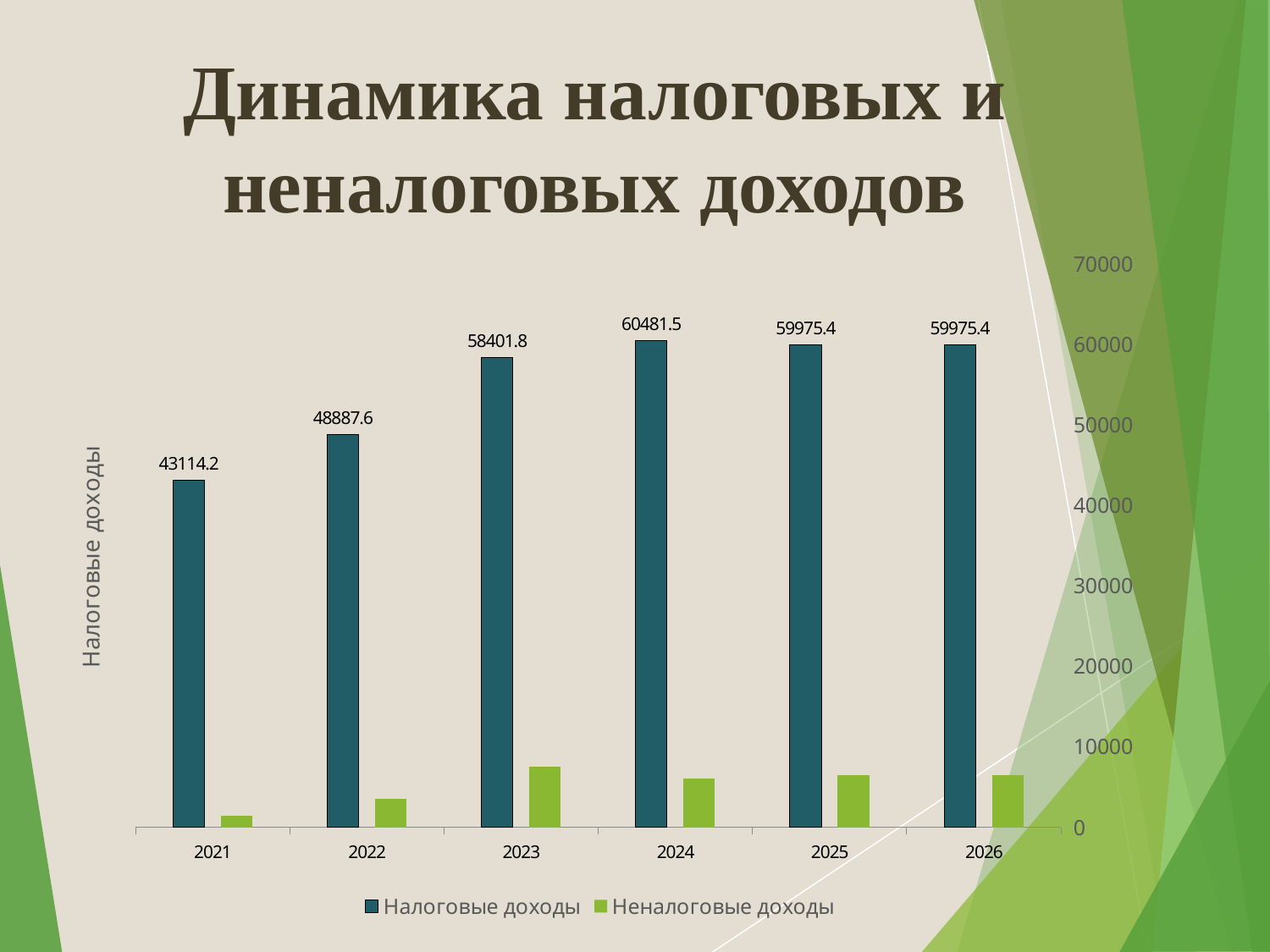
What is the difference between Налоговые доходы in 2022 and 2021? 5773.4 Which year has the highest value of Налоговые доходы? 2024 What is the value of Налоговые доходы for 2022? 48887.6 What is the value of Налоговые доходы for 2021? 43114.2 Which year has the lowest value of Налоговые доходы? 2021 How many years are shown on the x axis? 6 What is the value of Налоговые доходы for 2024? 60481.5 How many series does the legend list? 2 Which is larger: Налоговые доходы in 2023 or in 2022? 2023 Do the values of Налоговые доходы rise or fall from 2021 to 2024? rise Is the value of Неналоговые доходы for 2023 greater or less than 10000? less What kind of chart is shown on the slide? bar chart